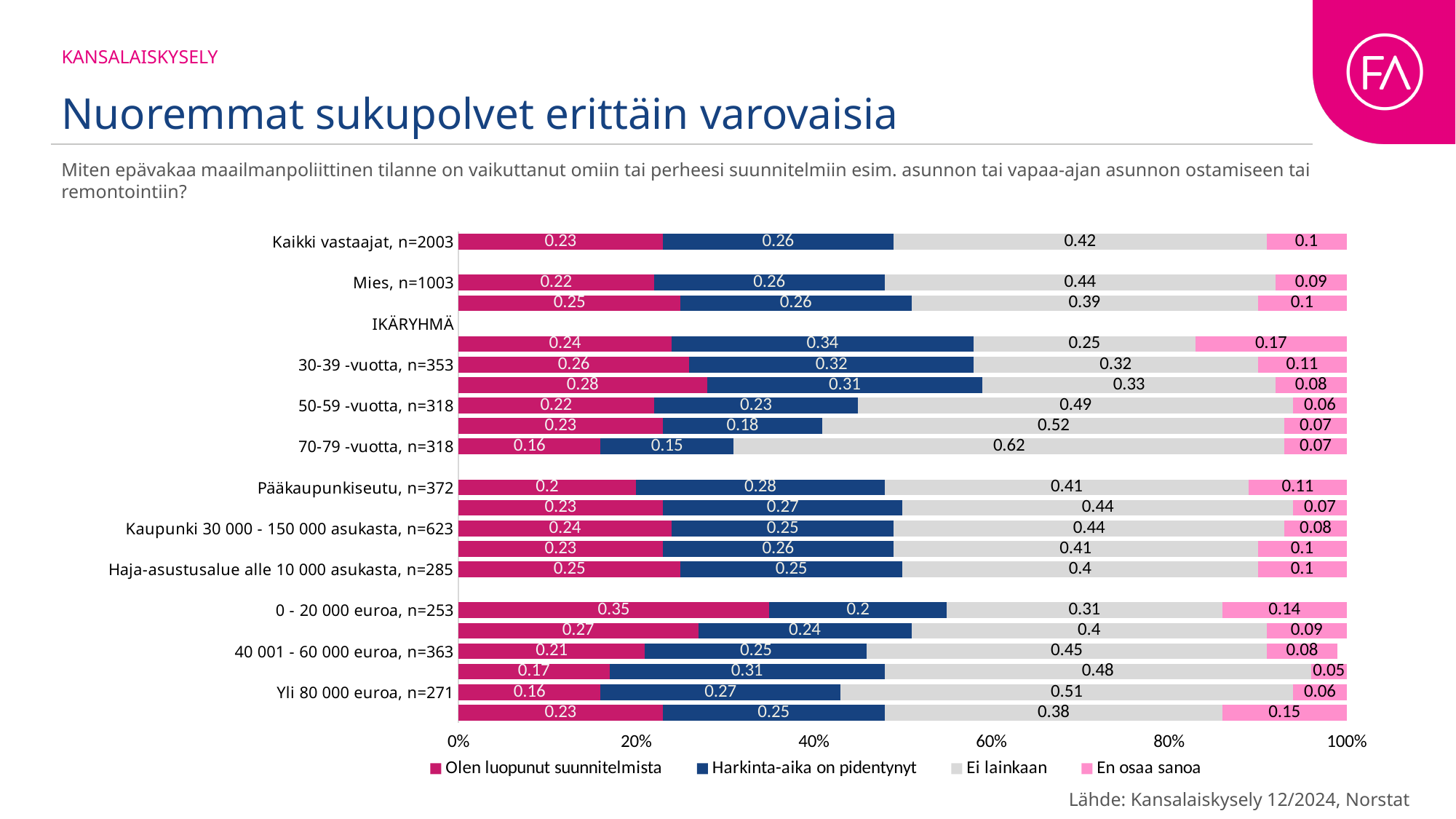
What is the last entry in the chart legend? En osaa sanoa How many series does the legend list? 4 Which is larger: the 'Ei lainkaan' value for '70-79 -vuotta, n=318' or for '30-39 -vuotta, n=353'? 70-79 -vuotta, n=318 What is the difference between the 'Olen luopunut suunnitelmista' values for '0 - 20 000 euroa, n=253' and 'Yli 80 000 euroa, n=271'? 0.19 What is the value of 'Ei lainkaan' for '70-79 -vuotta, n=318'? 0.62 What is the value of 'Harkinta-aika on pidentynyt' for 'Kaupunki 30 000 - 150 000 asukasta, n=623'? 0.25 What is the value of 'En osaa sanoa' for 'Mies, n=1003'? 0.09 What kind of chart is shown on the slide? Stacked bar chart What is the value of 'Ei lainkaan' for '50-59 -vuotta, n=318'? 0.49 What is the value of 'Harkinta-aika on pidentynyt' for 'Pääkaupunkiseutu, n=372'? 0.28 What is the value of 'Ei lainkaan' for 'Kaikki vastaajat, n=2003'? 0.42 What is the value of 'Olen luopunut suunnitelmista' for '0 - 20 000 euroa, n=253'? 0.35